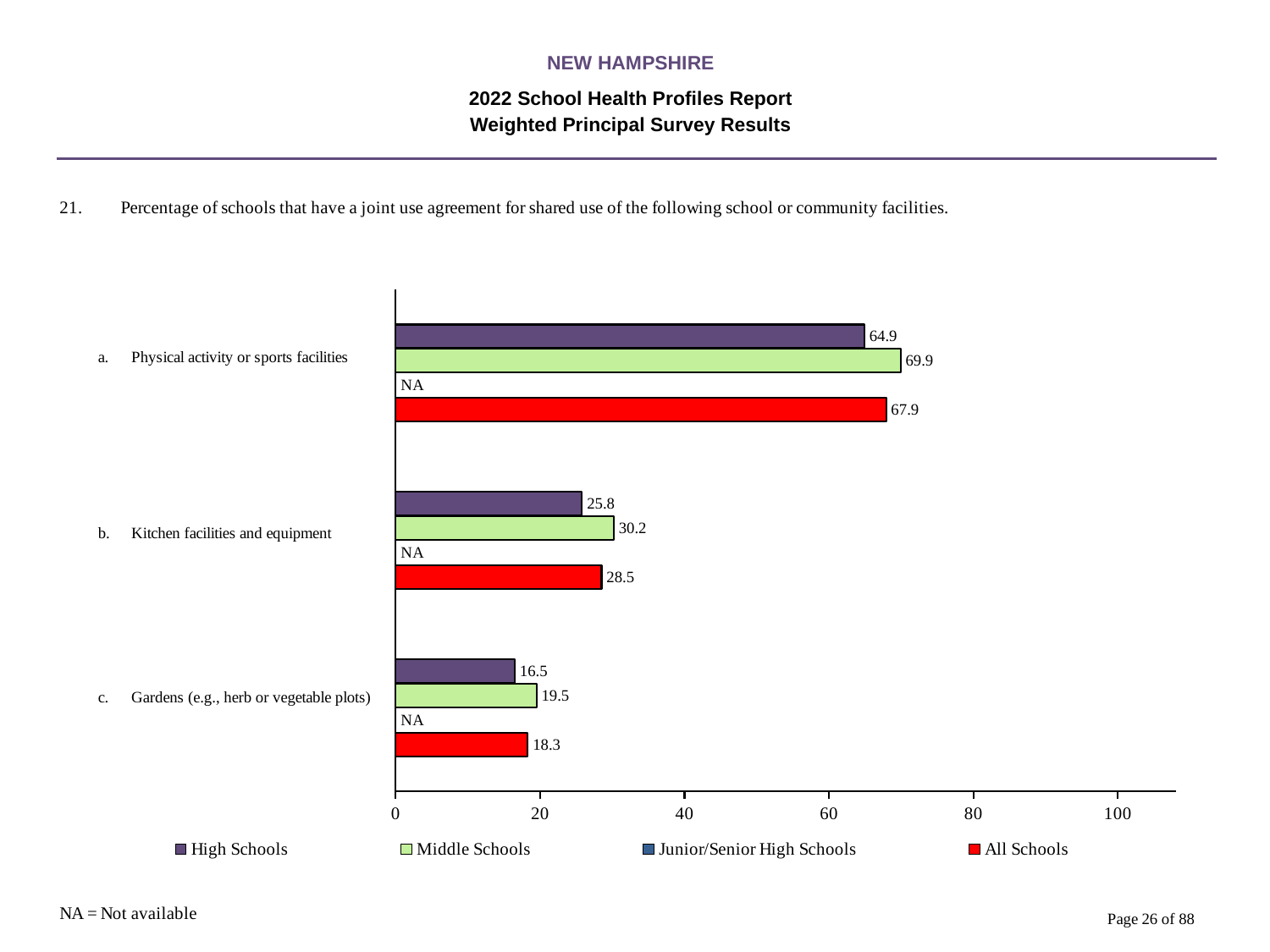
What is the value for All Schools for Kitchen facilities and equipment? 28.5 Which category has the highest value for All Schools? Physical activity or sports facilities Which category has the lowest value for Middle Schools? Gardens (e.g., herb or vegetable plots) How many series does the legend list? 4 Which is larger for Kitchen facilities and equipment: High Schools or Middle Schools? Middle Schools What is the difference between the Middle Schools and High Schools values for Physical activity or sports facilities? 5.0 Is the All Schools value for Physical activity or sports facilities greater or less than 60? greater What is the value for High Schools for Gardens (e.g., herb or vegetable plots)? 16.5 How many facility categories are shown in the chart? 3 What is shown for Junior/Senior High Schools for Kitchen facilities and equipment? NA What is the value for Middle Schools for Physical activity or sports facilities? 69.9 What kind of chart is shown on the slide? bar chart